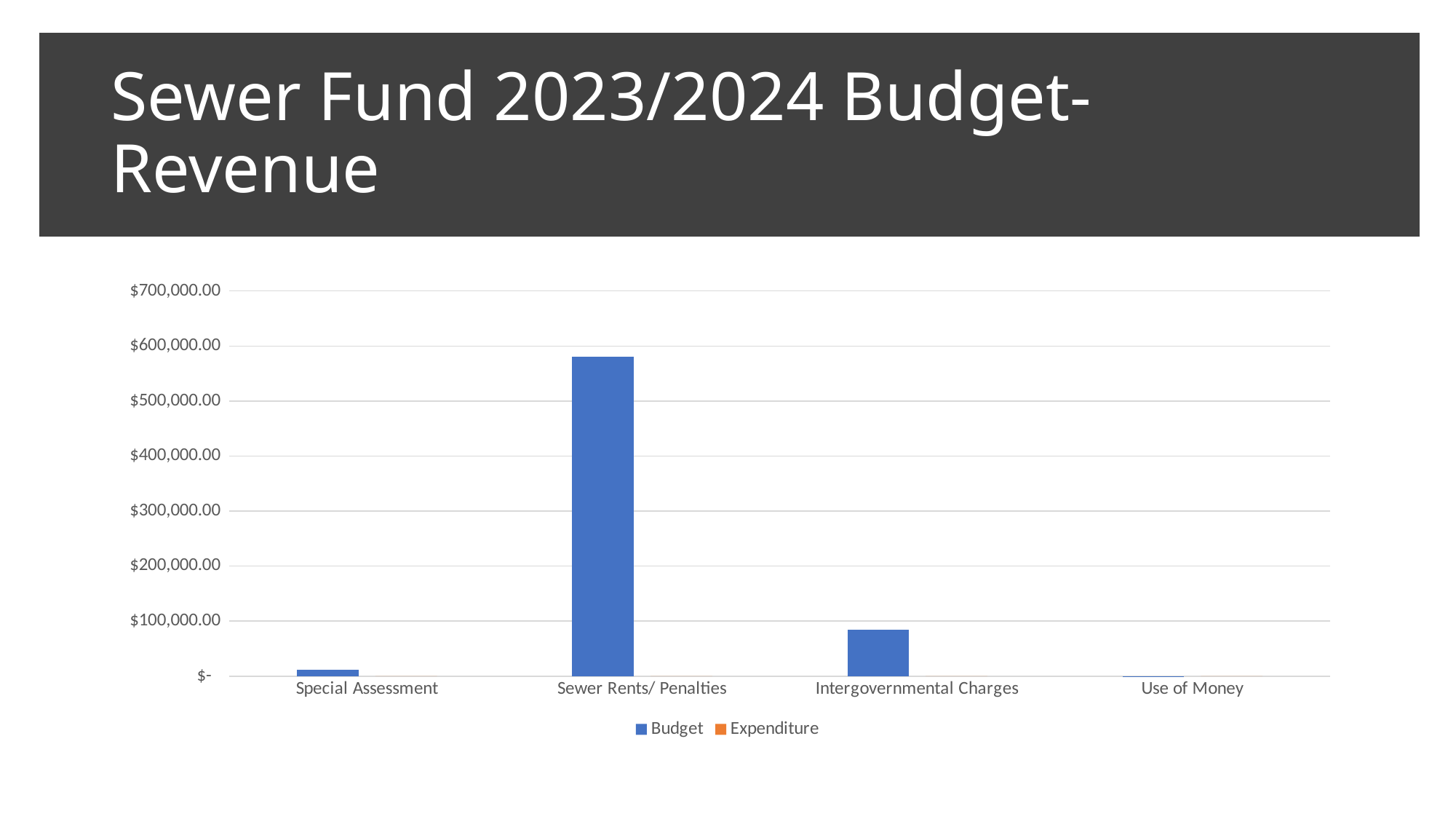
Is the Budget value for Intergovernmental Charges greater or less than $100,000.00? less Is the Budget value for Special Assessment greater or less than $100,000.00? less Which has a larger Budget value, Intergovernmental Charges or Special Assessment? Intergovernmental Charges How many categories are shown on the x axis of the chart? 4 Is the Budget value for Sewer Rents/ Penalties greater or less than $500,000.00? greater How many series does the chart's legend list? 2 What are the two series named in the chart's legend? Budget and Expenditure Which category has the lowest Budget value? Use of Money Which category has the highest Budget value? Sewer Rents/ Penalties What kind of chart is shown on the slide? bar chart What colour represents the Budget series in the chart? blue